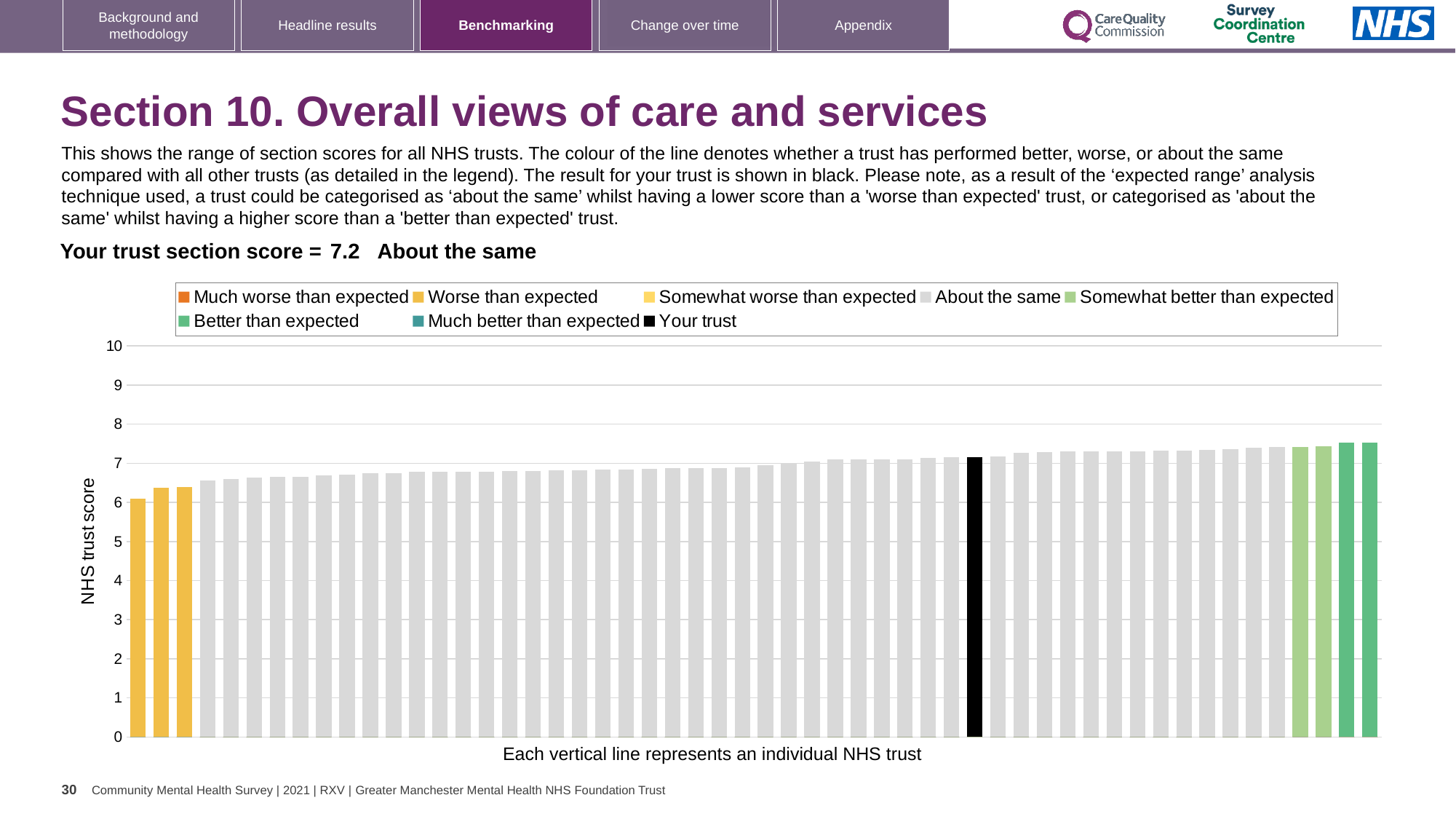
What is the label on the vertical axis of the chart? NHS trust score How many entries does the chart legend list? 8 What colour is the bar representing your trust? black How many bars are coloured as 'Better than expected'? 2 Is the value of the leftmost bar greater or less than 7? less What kind of chart is shown on the slide? bar chart Is the value of the rightmost bar greater or less than 8? less Do the bar values rise or fall from left to right along the x axis? rise What is the section score for your trust shown on the slide? 7.2 Is the value for your trust (the black bar) greater or less than 8? less How many bars are coloured as 'Worse than expected'? 3 How many bars are coloured as 'Somewhat better than expected'? 2